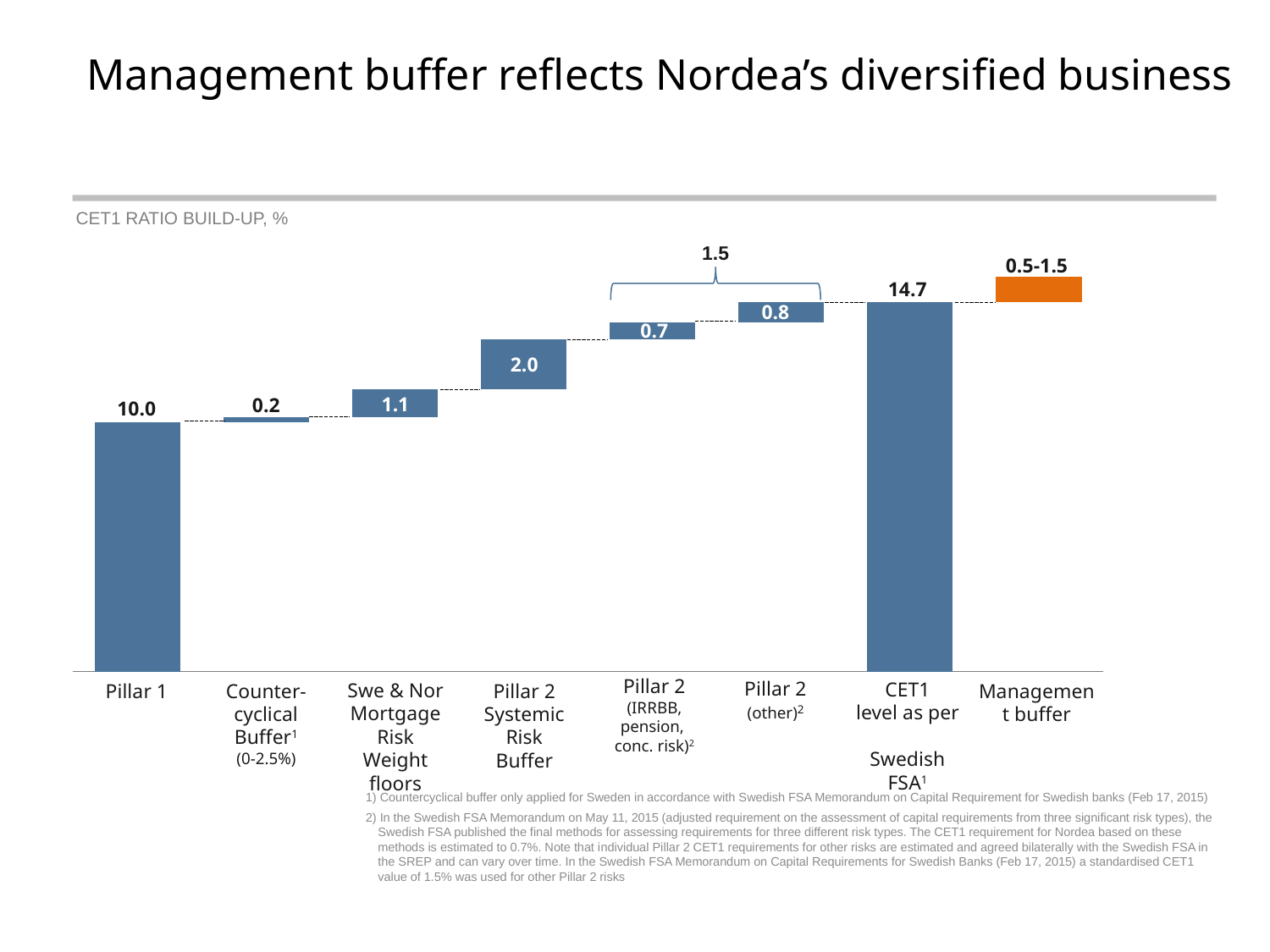
Which bar has the highest value on the chart? CET1 level as per Swedish FSA What range is shown for the Management buffer? 0.5-1.5 What is the value shown for Pillar 1? 10.0 What type of chart is shown on the slide? Bar chart (waterfall) What is the value shown for the Pillar 2 Systemic Risk Buffer? 2.0 What is the value shown for the Swe & Nor Mortgage Risk Weight floors? 1.1 What is the subtitle of the chart? CET1 RATIO BUILD-UP, % What is the CET1 level as per Swedish FSA shown on the chart? 14.7 What is the combined value shown by the bracket over the two Pillar 2 (IRRBB, pension, conc. risk) and Pillar 2 (other) bars? 1.5 Which component has the smallest value on the chart? Countercyclical Buffer What is the difference between the Pillar 2 Systemic Risk Buffer and the Swe & Nor Mortgage Risk Weight floors? 0.9 Which is larger, Pillar 2 (other) or Pillar 2 (IRRBB, pension, conc. risk)? Pillar 2 (other)